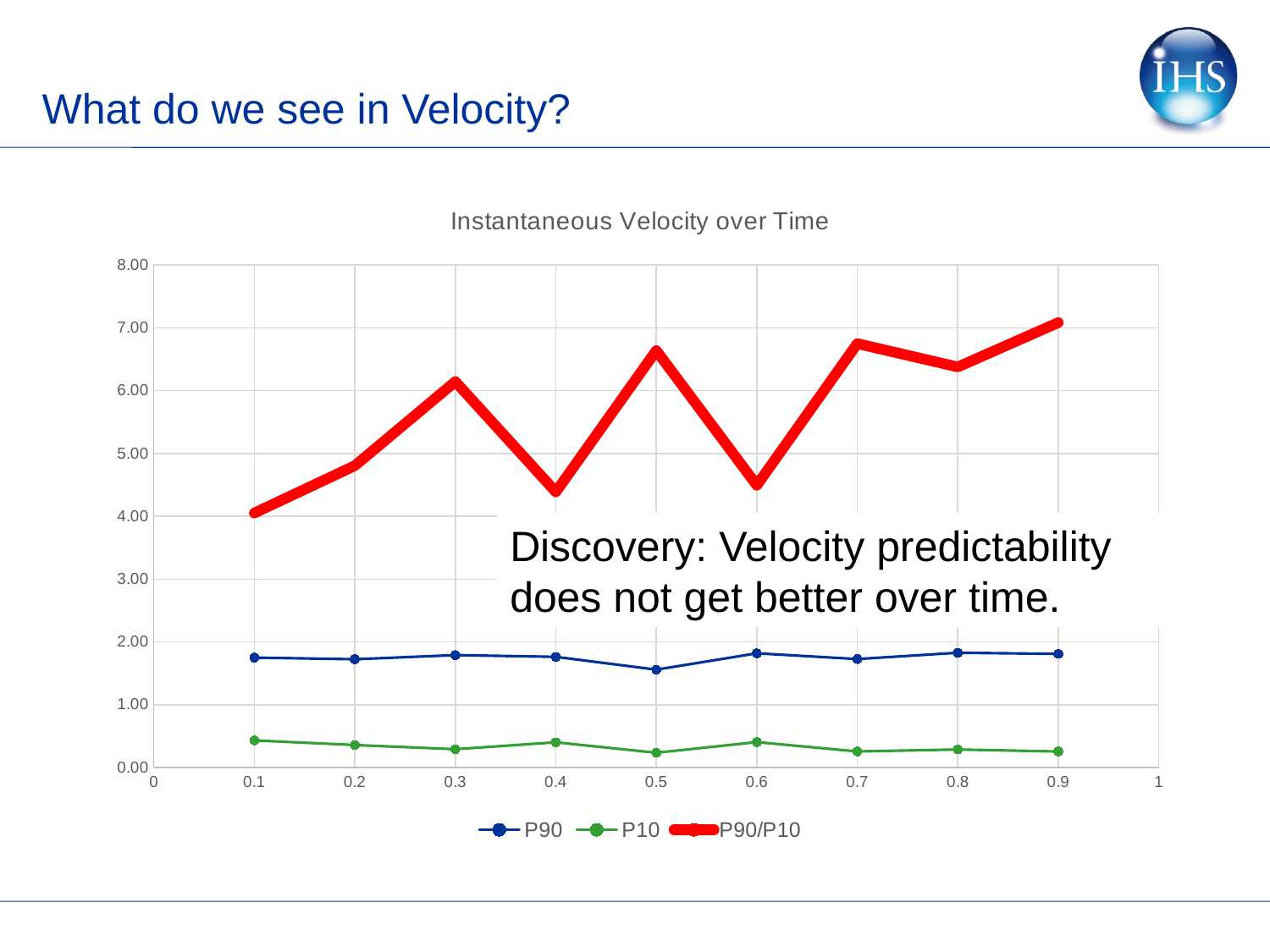
How many series does the legend list? 3 Is the P90 value at x = 0.5 greater or less than 2.00? less Which series is drawn with the thick red line? P90/P10 Which is larger, the P90/P10 value at x = 0.5 or at x = 0.6? 0.5 What is the title of the chart? Instantaneous Velocity over Time What kind of chart is shown on the slide? line chart Is the P90/P10 value at x = 0.3 greater or less than 6.00? greater At which x value is the P90/P10 series lowest? 0.1 Is the P90/P10 value at x = 0.4 greater or less than 5.00? less Does the P90/P10 series rise or fall between x = 0.1 and x = 0.3? rise How many data points are plotted for the P90/P10 series? 9 At which x value is the P90/P10 series highest? 0.9